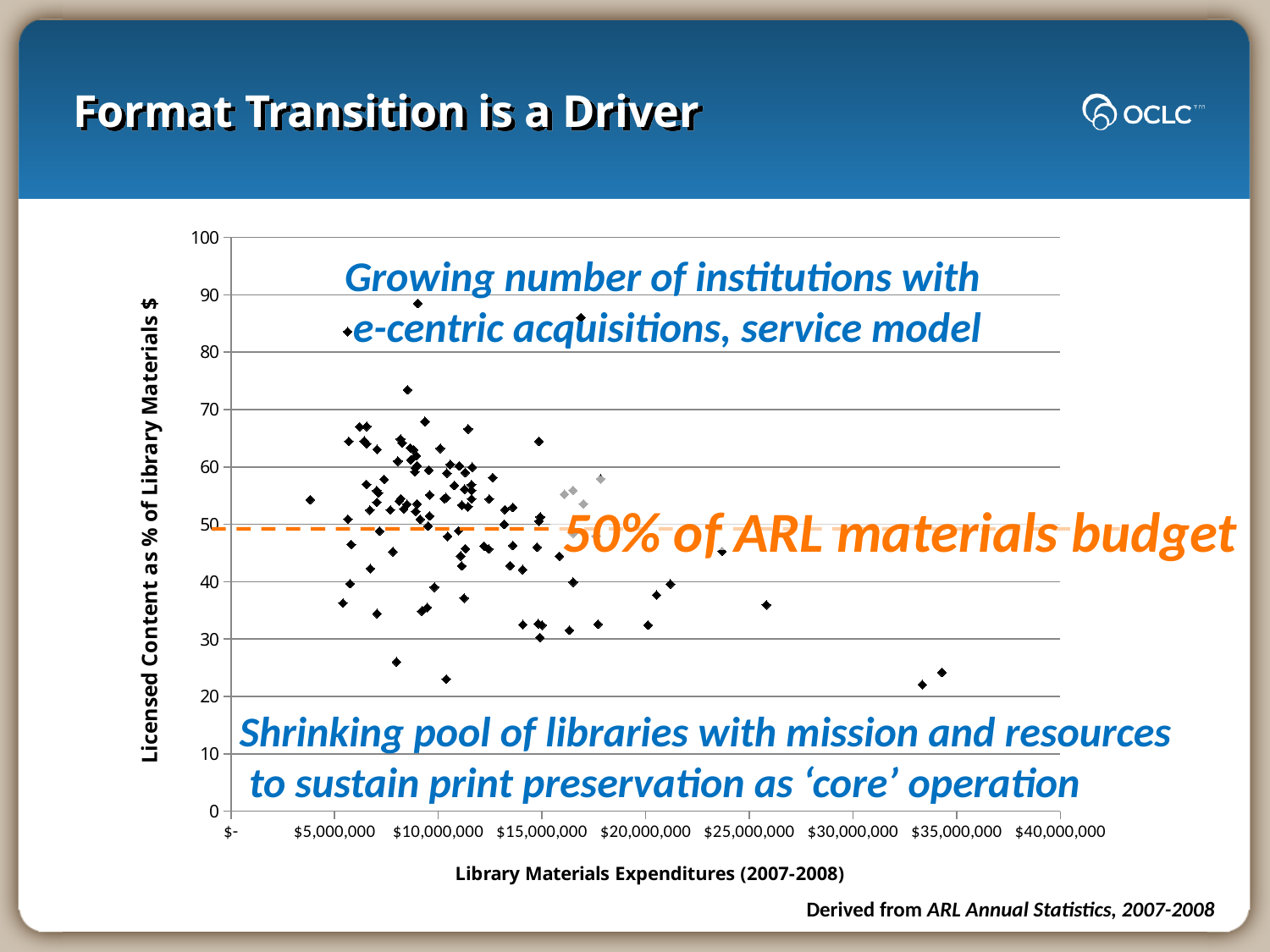
What is the title of the horizontal axis of the chart? Library Materials Expenditures (2007-2008) What kind of chart is shown on the slide? scatter plot Is the highest plotted point on the chart greater or less than 80 on the vertical axis? greater Is the lowest plotted point on the chart greater or less than 30 on the vertical axis? less Are the points with expenditures above $30,000,000 above or below the 50% reference line? below Is the point with the largest library materials expenditure greater or less than 30 on the vertical axis? less What is the title of the vertical axis of the chart? Licensed Content as % of Library Materials $ At what value on the vertical axis is the dashed orange reference line drawn? 50